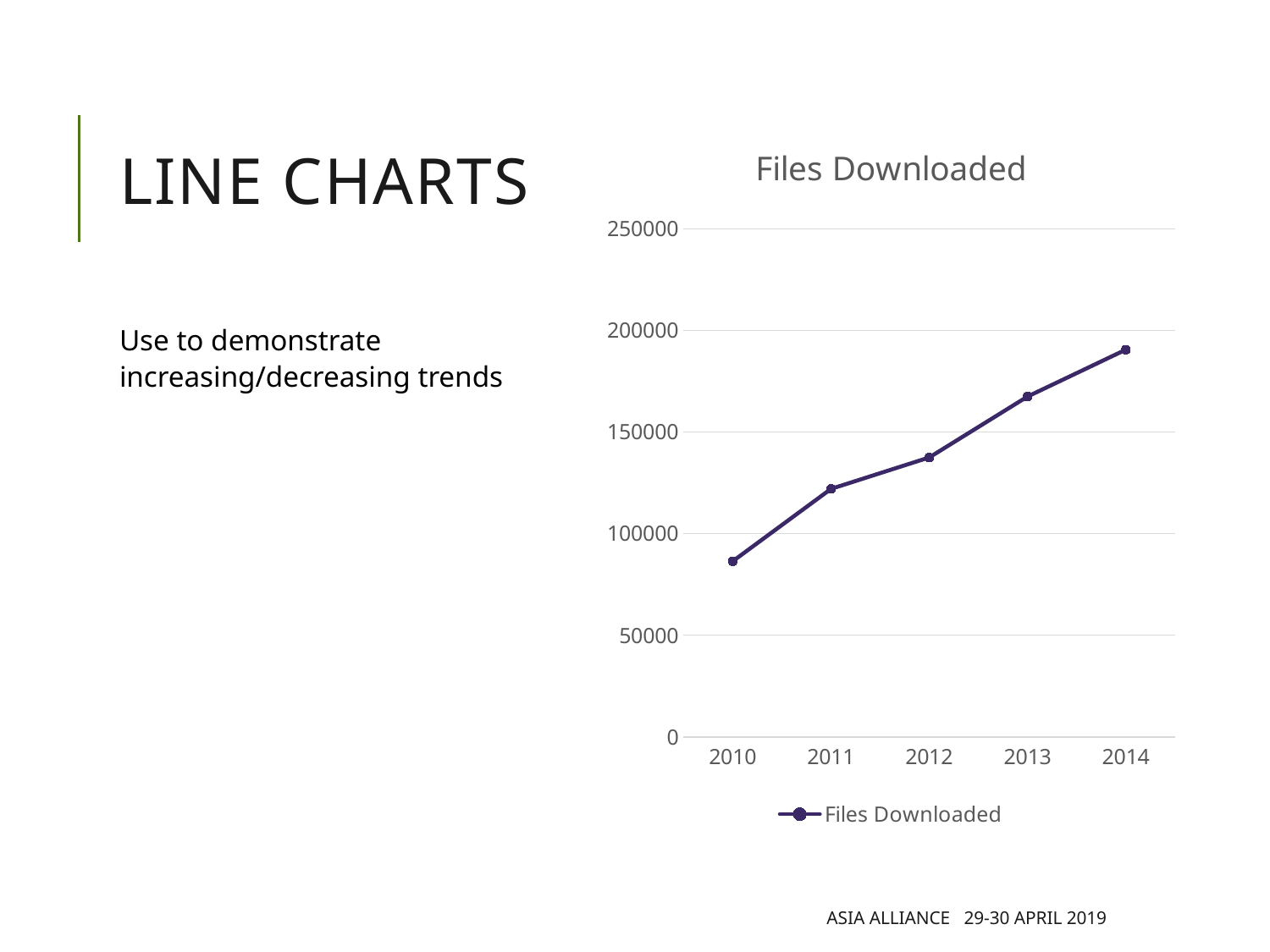
How many years are plotted on the x axis of the chart? 5 Which year has the larger value for Files Downloaded, 2011 or 2013? 2013 Is the value for 2011 greater or less than 100000? greater Is the value for 2010 greater or less than 100000? less Which year has the lowest value for Files Downloaded? 2010 What is the title of the chart? Files Downloaded Which year has the highest value for Files Downloaded? 2014 Is the value for 2013 greater or less than 150000? greater How many series does the chart's legend list? 1 Do the values for Files Downloaded rise or fall from 2010 to 2014? rise What kind of chart is shown on the slide? line chart